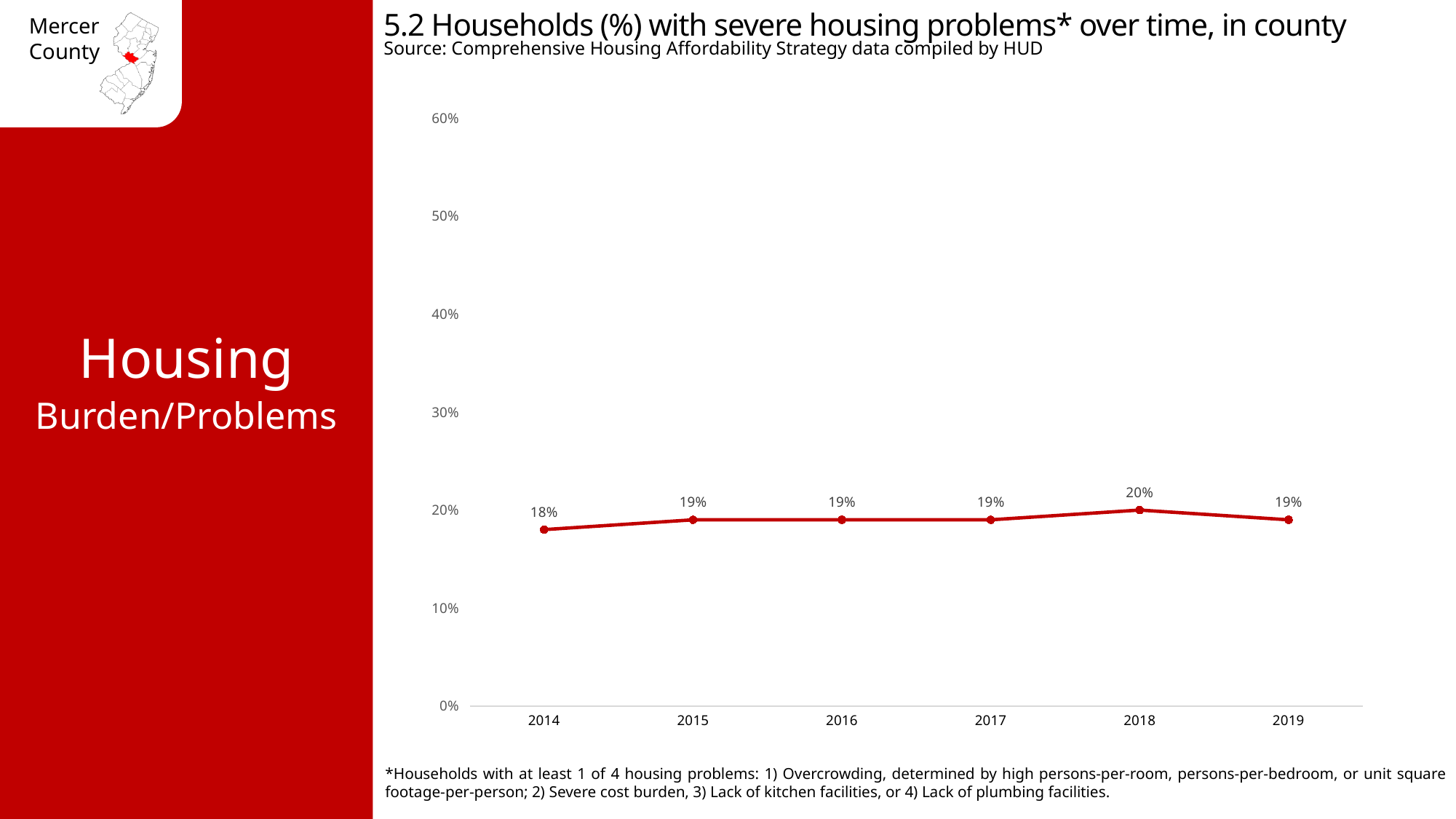
What is the value shown for 2019? 19% What is the source of the data shown in the chart? Comprehensive Housing Affordability Strategy data compiled by HUD How many years are plotted on the chart? 6 What is the difference between the 2018 value and the 2014 value? 2% What is the value shown for 2018? 20% Which year has the lowest percentage of households with severe housing problems? 2014 What percentage of households had severe housing problems in 2014? 18% Which is larger, the value for 2014 or the value for 2018? 2018 Which year has the highest percentage of households with severe housing problems? 2018 What kind of chart is shown on the slide? line chart Does the value rise or fall from 2014 to 2015? rise Is the value for 2016 greater or less than 30%? less